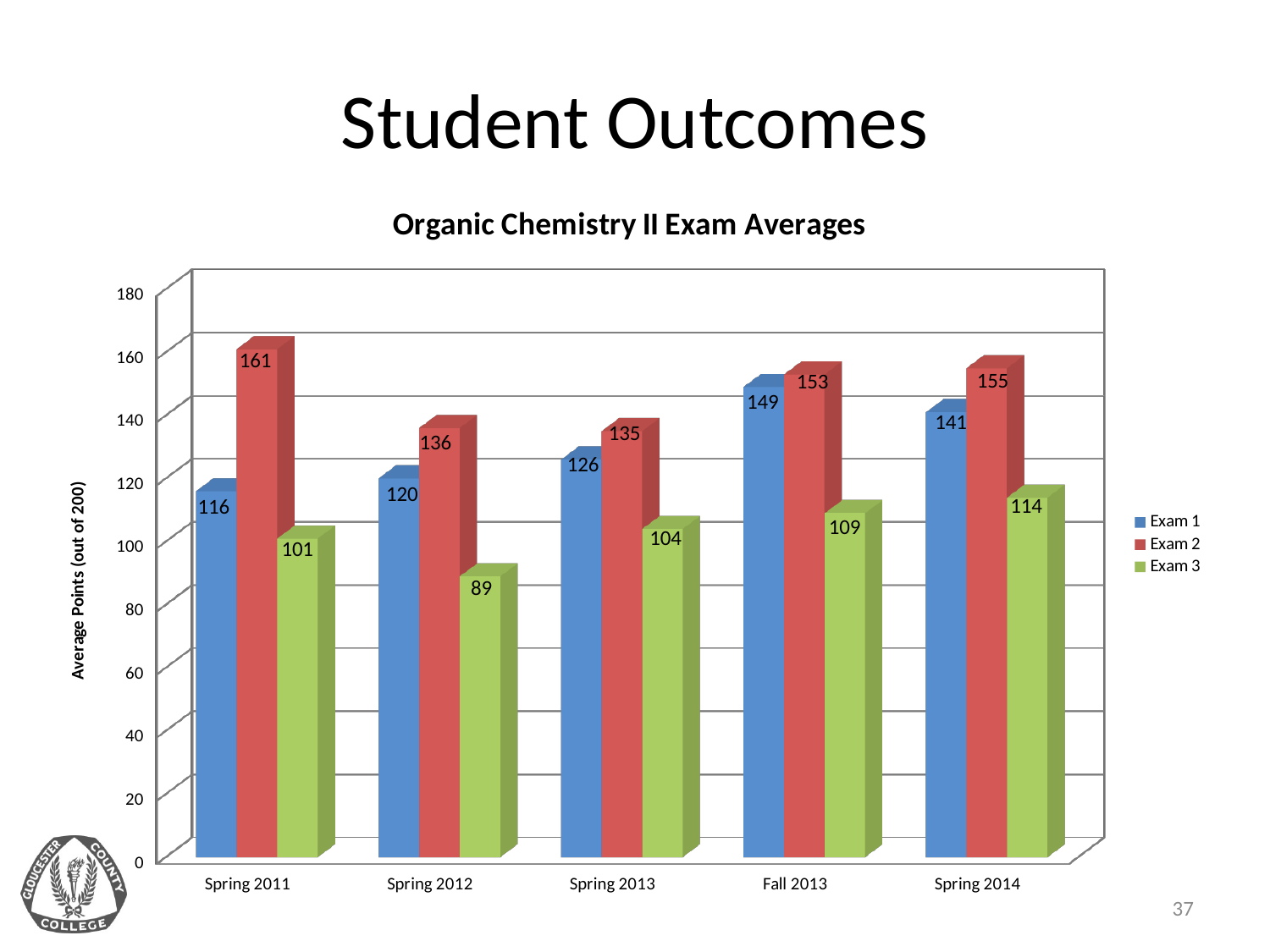
What is the Exam 1 average for Spring 2013? 126 Which semester has the lowest Exam 3 average? Spring 2012 What is the Exam 3 average for Spring 2012? 89 What is the title of the chart? Organic Chemistry II Exam Averages What is the difference between the Exam 2 and Exam 3 averages for Spring 2011? 60 How many semesters are shown on the x axis? 5 How many series does the legend list? 3 Which semester has the highest Exam 2 average? Spring 2011 Do the Exam 1 averages rise or fall from Spring 2011 to Fall 2013? Rise What kind of chart is shown on the slide? Bar chart Which is larger, the Exam 1 average for Fall 2013 or for Spring 2014? Fall 2013 What is the Exam 2 average for Fall 2013? 153